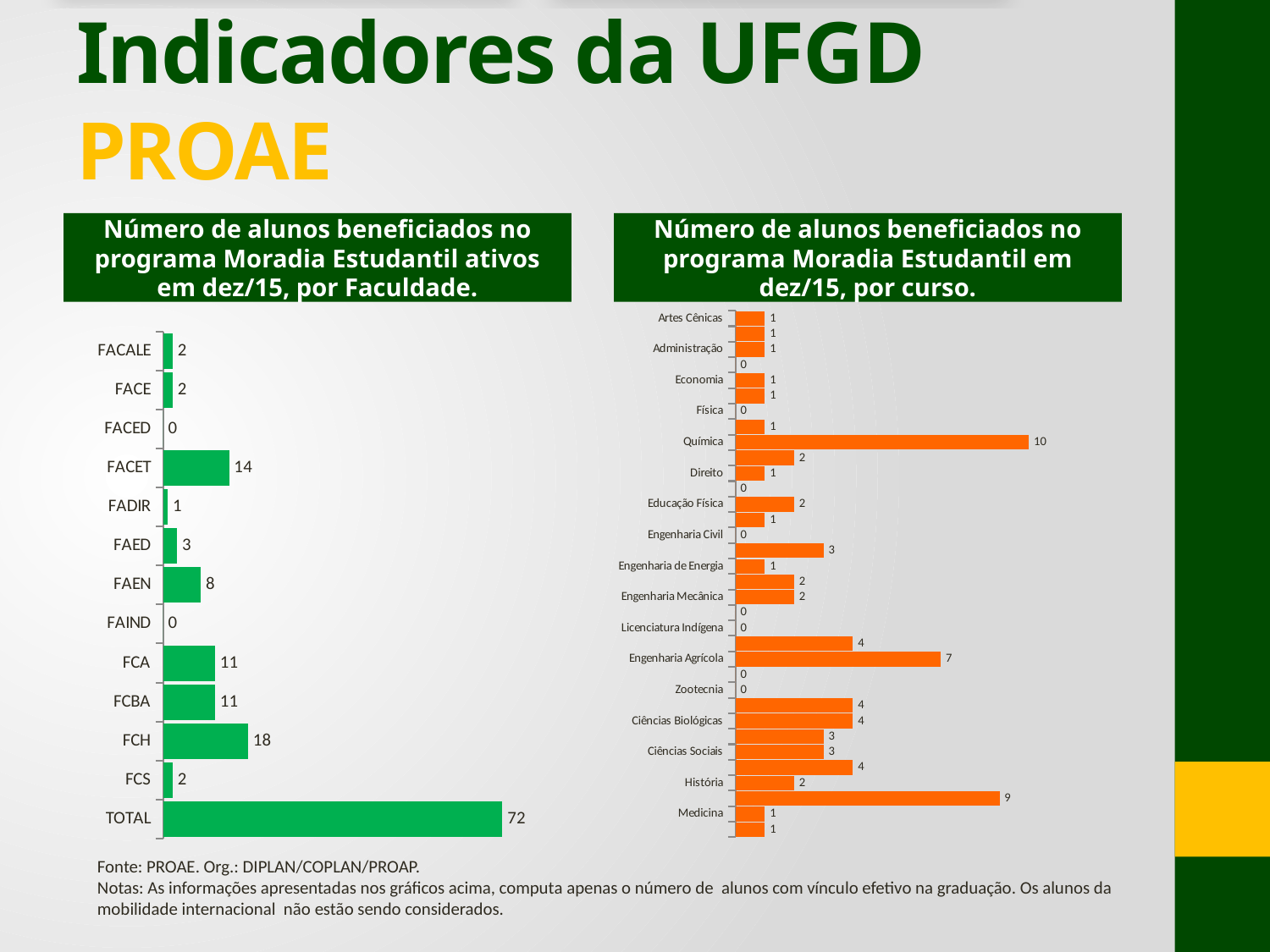
In the chart on the right (por curso), what is the value for Química? 10 In the chart on the left (por Faculdade), what is the value for FACET? 14 What type of chart is the chart on the right (por curso)? Bar chart In the chart on the left (por Faculdade), which is larger, FAEN or FAED? FAEN In the chart on the left (por Faculdade), what is the difference between FCH and FACET? 4 In the chart on the left (por Faculdade), what is the value for TOTAL? 72 In the chart on the left (por Faculdade), what is the value for FAEN? 8 In the chart on the left (por Faculdade), which faculty (excluding TOTAL) has the highest value? FCH In the chart on the left (por Faculdade), what is the value for FCH? 18 In the chart on the right (por curso), which course has the highest value? Química In the chart on the left (por Faculdade), how many categories are shown, including TOTAL? 13 In the chart on the left (por Faculdade), which faculties have a value of 0? FACED and FAIND